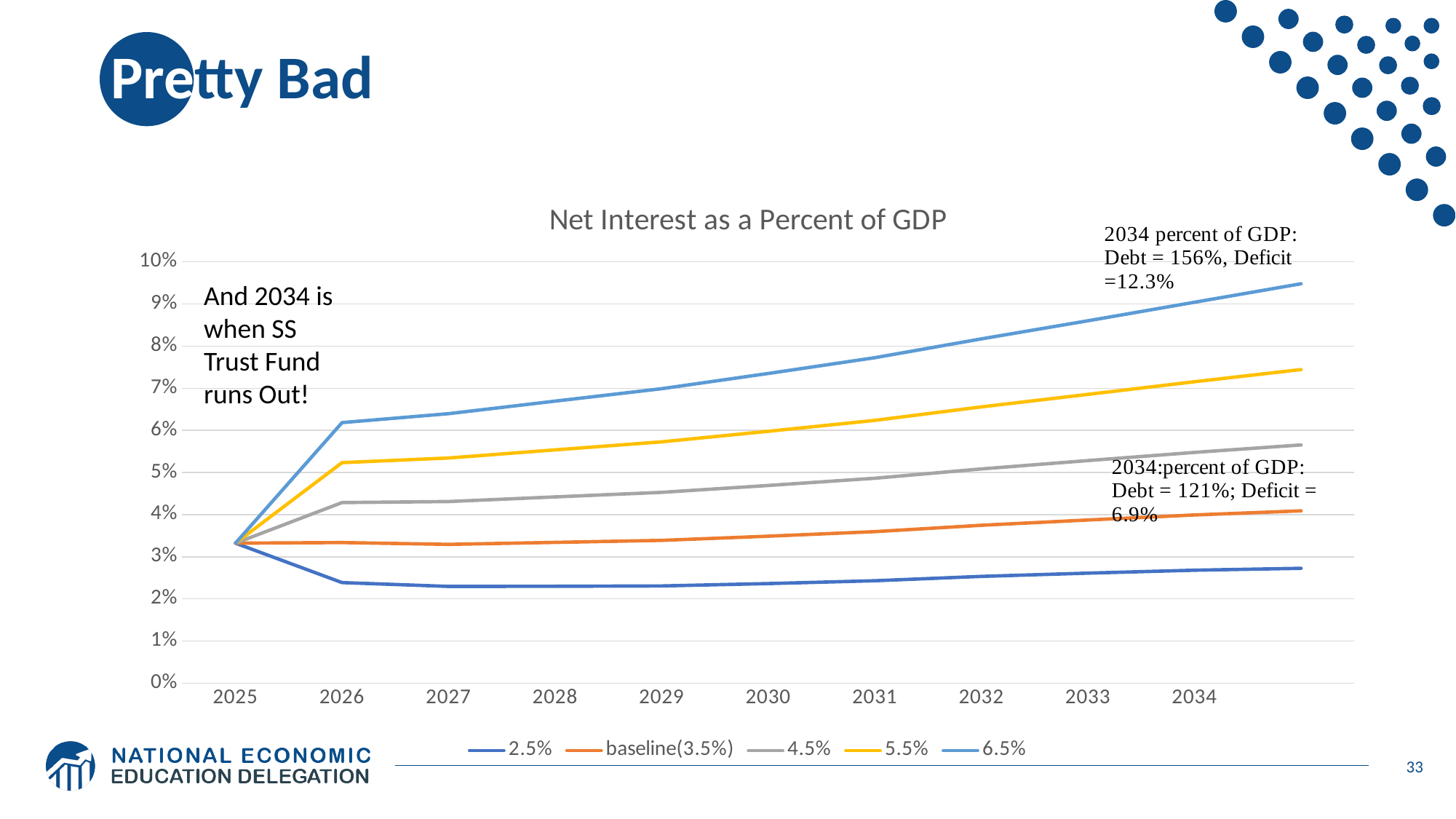
What is the title of the chart? Net Interest as a Percent of GDP Is the value for the 5.5% series in 2034 greater or less than 6%? greater In 2030, which series has the larger value: 5.5% or 4.5%? 5.5% Is the value for the baseline(3.5%) series in 2030 greater or less than 4%? less Which series has the lowest net interest as a percent of GDP in 2034? 2.5% Is the value for the 6.5% series in 2034 greater or less than 8%? greater Does the 6.5% series rise or fall from 2026 to 2034? rise How many series does the chart's legend list? 5 Which series has the highest net interest as a percent of GDP in 2034? 6.5% Does the 2.5% series rise or fall from 2025 to 2026? fall What kind of chart is shown on the slide? line chart